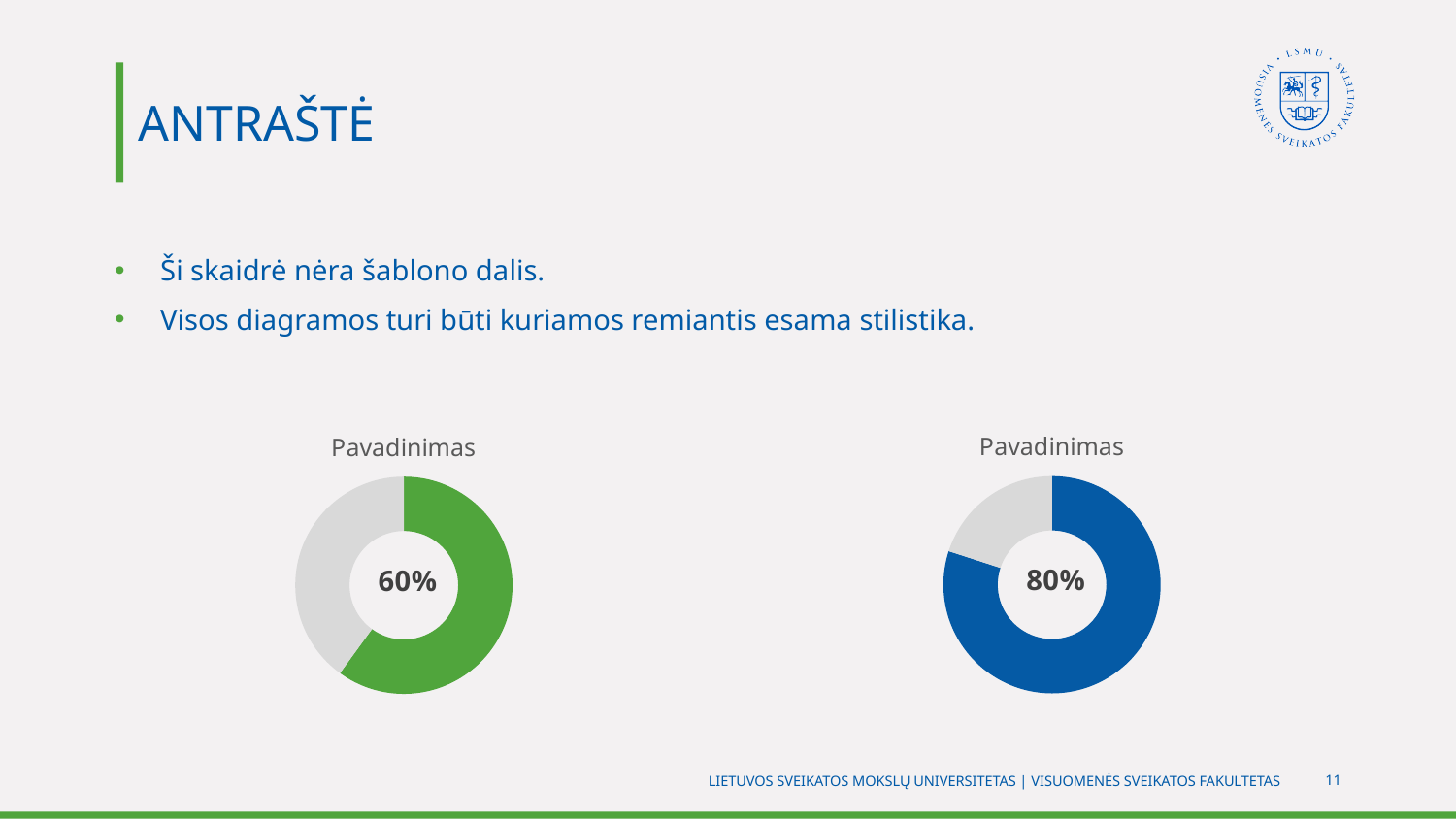
Which chart shows the larger percentage, the left one or the right one? The right one What kind of chart is the left chart? Doughnut (pie) chart How many charts are shown on the slide? 2 What is the title of the left chart? Pavadinimas On the right chart, what share of the doughnut does the blue segment represent? 80% On the right chart, what percentage is printed in the centre of the doughnut? 80% What colour is the filled segment of the right chart? Blue What is the difference between the percentage on the right chart and the percentage on the left chart? 20 percentage points On the left chart, what share of the doughnut does the green segment represent? 60% On the left chart, what percentage is printed in the centre of the doughnut? 60%